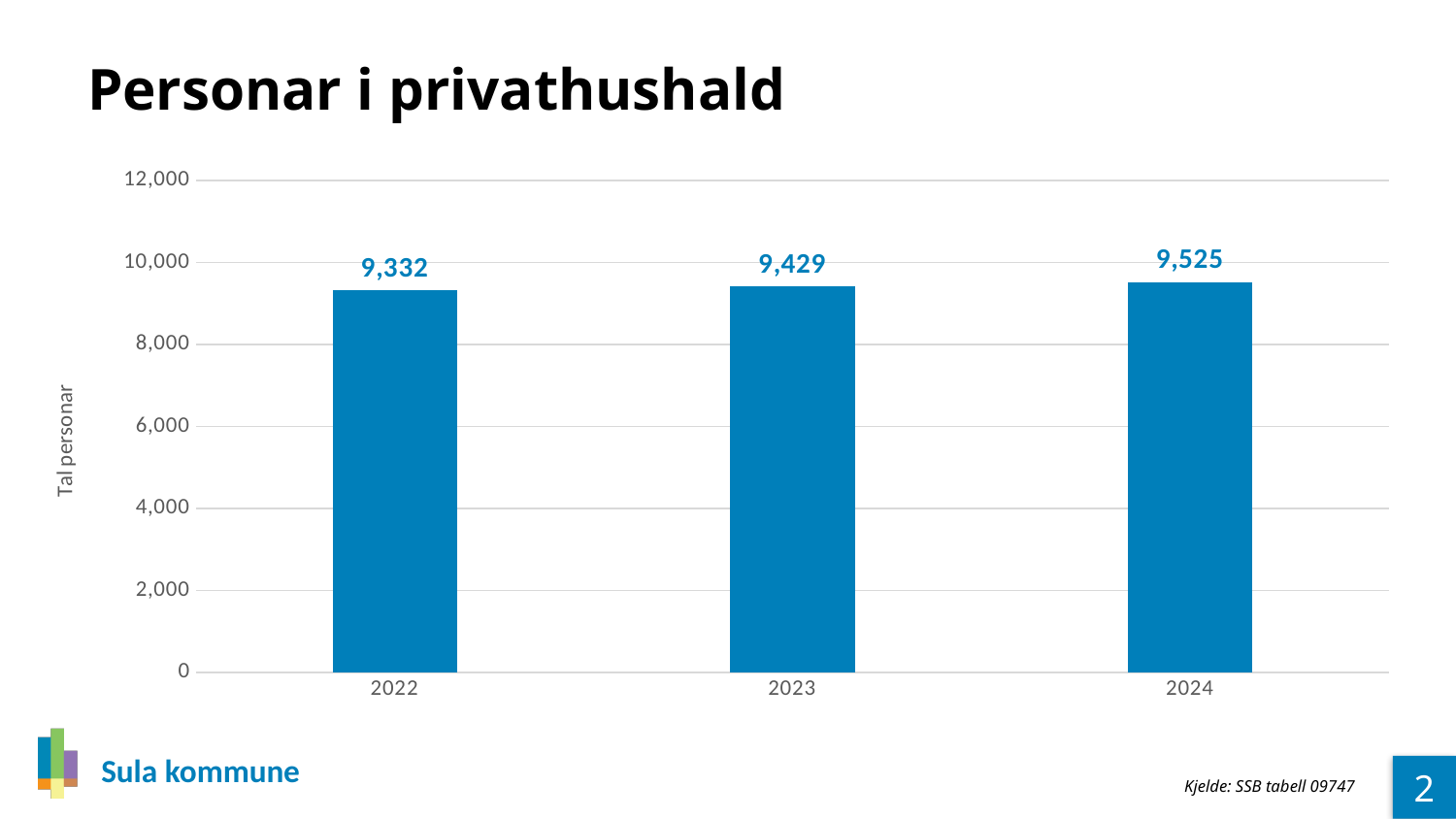
Which year has the highest value? 2024 What is the value for 2023? 9,429 Do the values rise or fall from 2022 to 2024? rise Which is larger, the value for 2023 or the value for 2024? 2024 What is the value for 2022? 9,332 How many years are shown on the x axis? 3 What kind of chart is shown on the slide? bar chart Which year has the lowest value? 2022 What is the difference between the values for 2024 and 2022? 193 Is the value for 2022 greater or less than 10,000? less What is the difference between the values for 2023 and 2022? 97 What is the value for 2024? 9,525